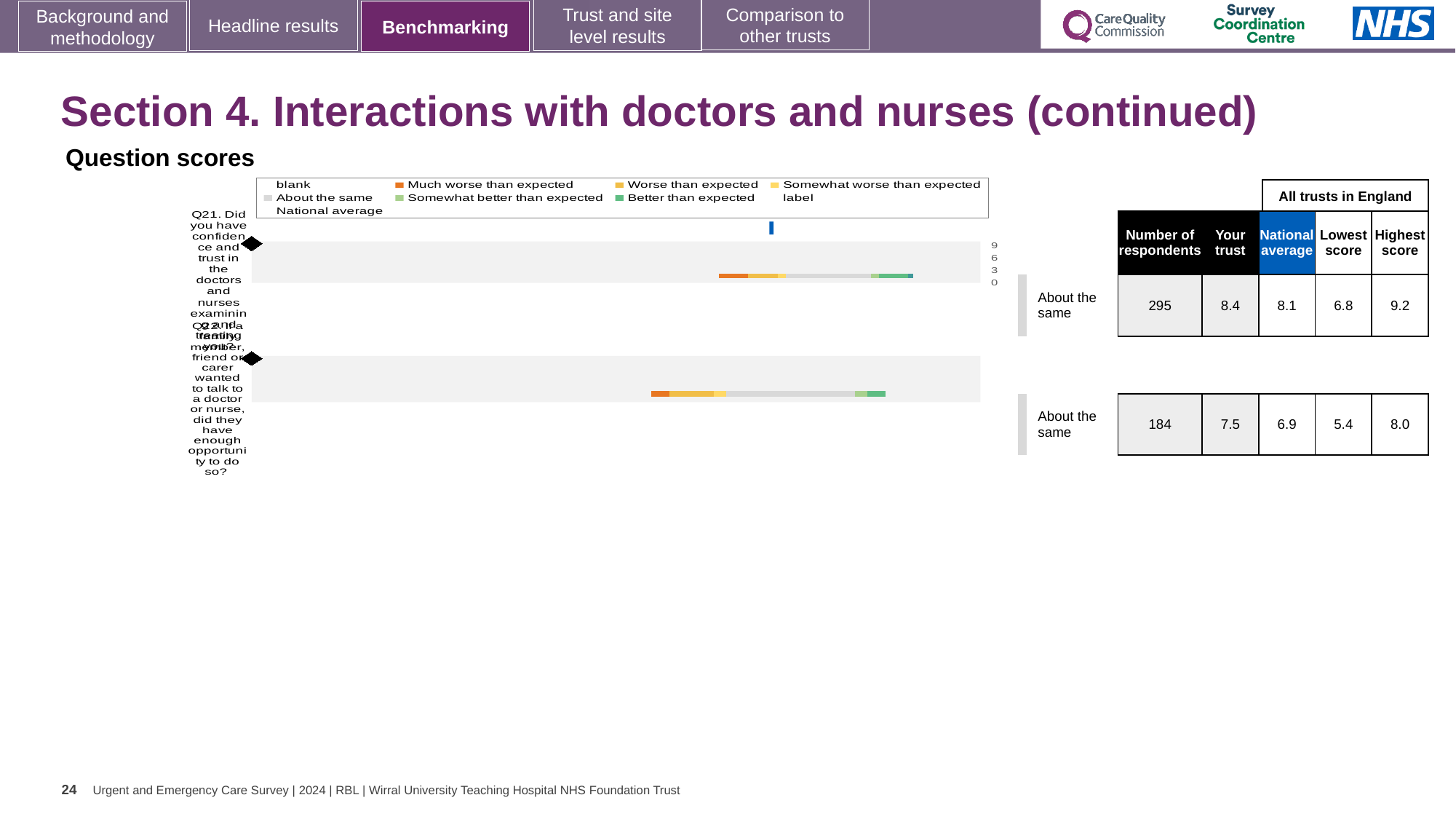
What is the difference between the trust's score and the national average for Q22? 0.6 How many respondents answered Q22? 184 Which question has the higher 'Your trust' score, Q21 or Q22? Q21 What is the 'Your trust' score for Q21 (confidence and trust in the doctors and nurses examining and treating you)? 8.4 What kind of chart is used to show the question scores? Bar chart What is the highest score across all trusts in England for Q21? 9.2 What is the lowest score across all trusts in England for Q22? 5.4 What is the difference between the trust's score and the national average for Q21? 0.3 How many questions are plotted in the chart? 2 What is the national average score for Q22 (enough opportunity for a family member, friend or carer to talk to a doctor or nurse)? 6.9 What benchmark category is shown for both Q21 and Q22? About the same How many respondents answered Q21? 295